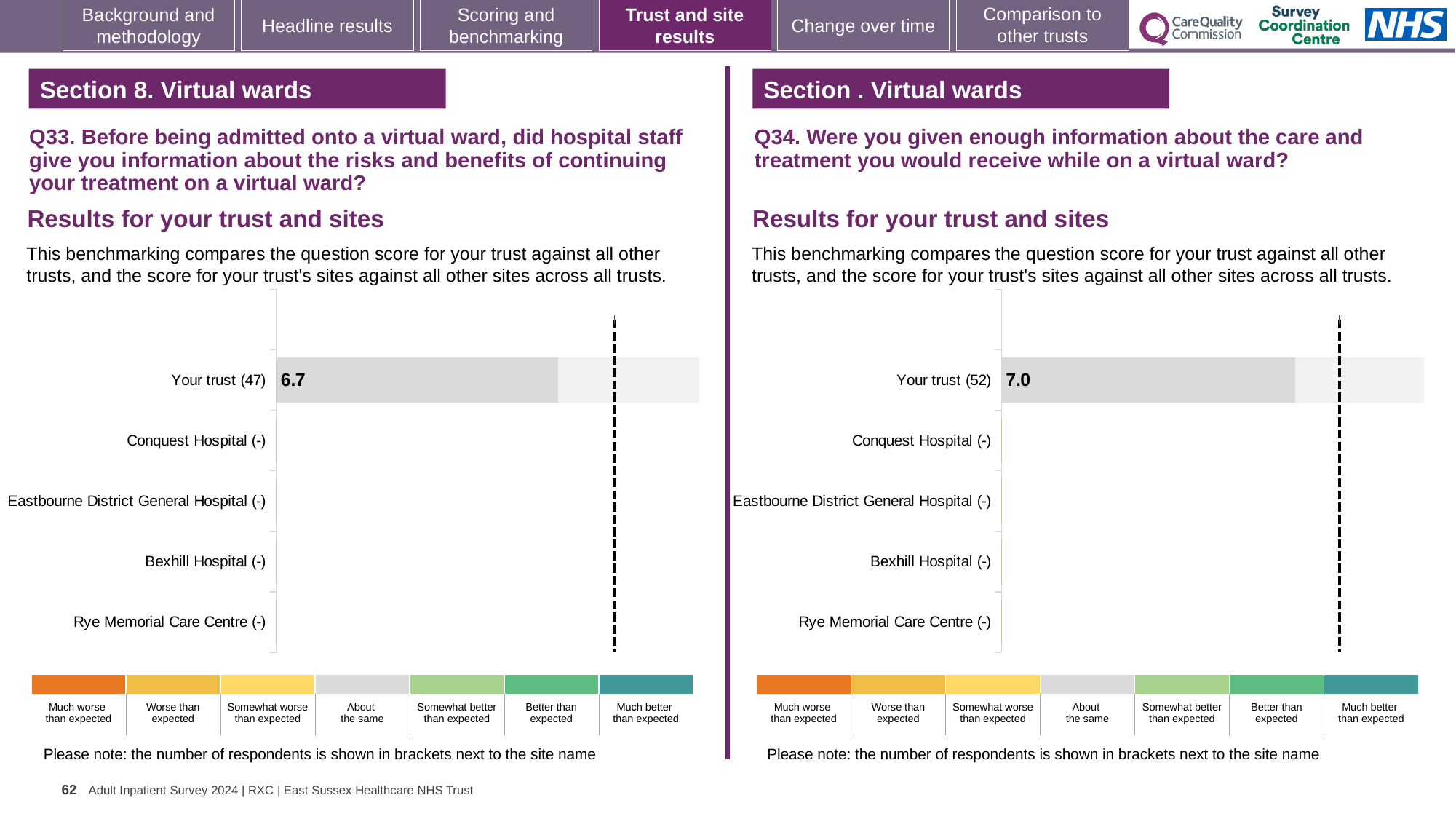
On the left chart (Q33), how many respondents are shown in brackets for Your trust? 47 Which is larger: the Your trust score on the left chart (Q33) or on the right chart (Q34)? Right chart (Q34), 7.0 On the right chart (Q34), how many respondents are shown in brackets for Your trust? 52 How many categories (sites) are listed on the right chart (Q34)? 5 How many benchmark bands are shown in the colour key below the right chart (Q34)? 7 On the left chart (Q33), what is the score for Your trust? 6.7 On the left chart (Q33), which category is the only one with a plotted bar? Your trust (47) What kind of chart is used on the left (Q33)? Bar chart On the right chart (Q34), what is the score for Your trust? 7.0 What is the difference between the Your trust score on the right chart (Q34) and on the left chart (Q33)? 0.3 How many categories (sites) are listed on the left chart (Q33)? 5